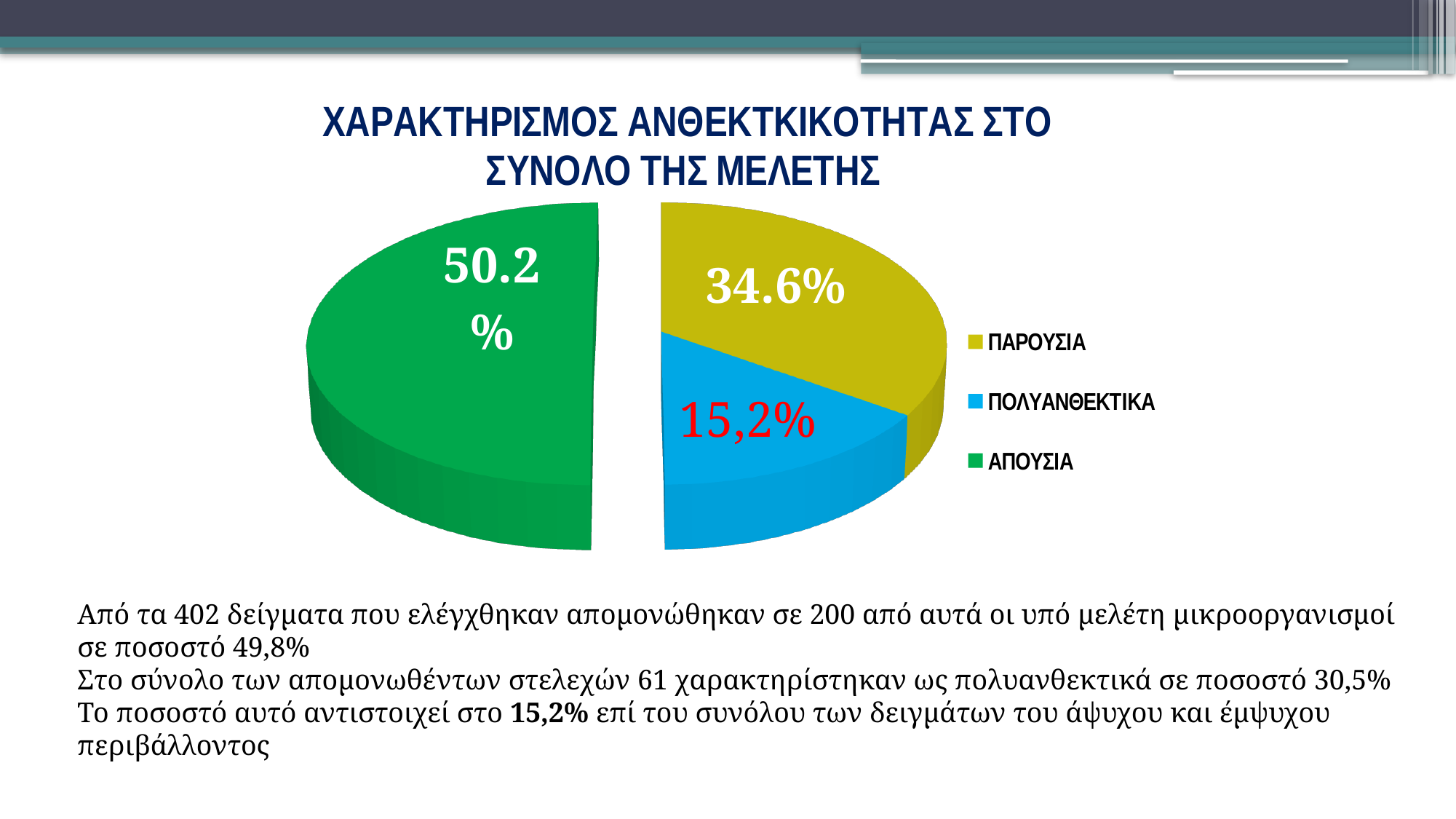
What percentage is shown for the ΑΠΟΥΣΙΑ slice? 50.2% What percentage is shown for the ΠΟΛΥΑΝΘΕΚΤΙΚΑ slice? 15,2% Which category has the smallest slice of the pie? ΠΟΛΥΑΝΘΕΚΤΙΚΑ What percentage is shown for the ΠΑΡΟΥΣΙΑ slice? 34.6% What colour is the ΑΠΟΥΣΙΑ slice? green Which category has the largest slice of the pie? ΑΠΟΥΣΙΑ What type of chart is shown on the slide? pie chart How many slices does the pie chart have? 3 What is the difference in percentage points between the ΠΑΡΟΥΣΙΑ and ΠΟΛΥΑΝΘΕΚΤΙΚΑ slices? 19.4 Which slice is larger, ΠΑΡΟΥΣΙΑ or ΠΟΛΥΑΝΘΕΚΤΙΚΑ? ΠΑΡΟΥΣΙΑ What is the difference in percentage points between the ΑΠΟΥΣΙΑ and ΠΑΡΟΥΣΙΑ slices? 15.6 Which legend entry is shown in blue? ΠΟΛΥΑΝΘΕΚΤΙΚΑ